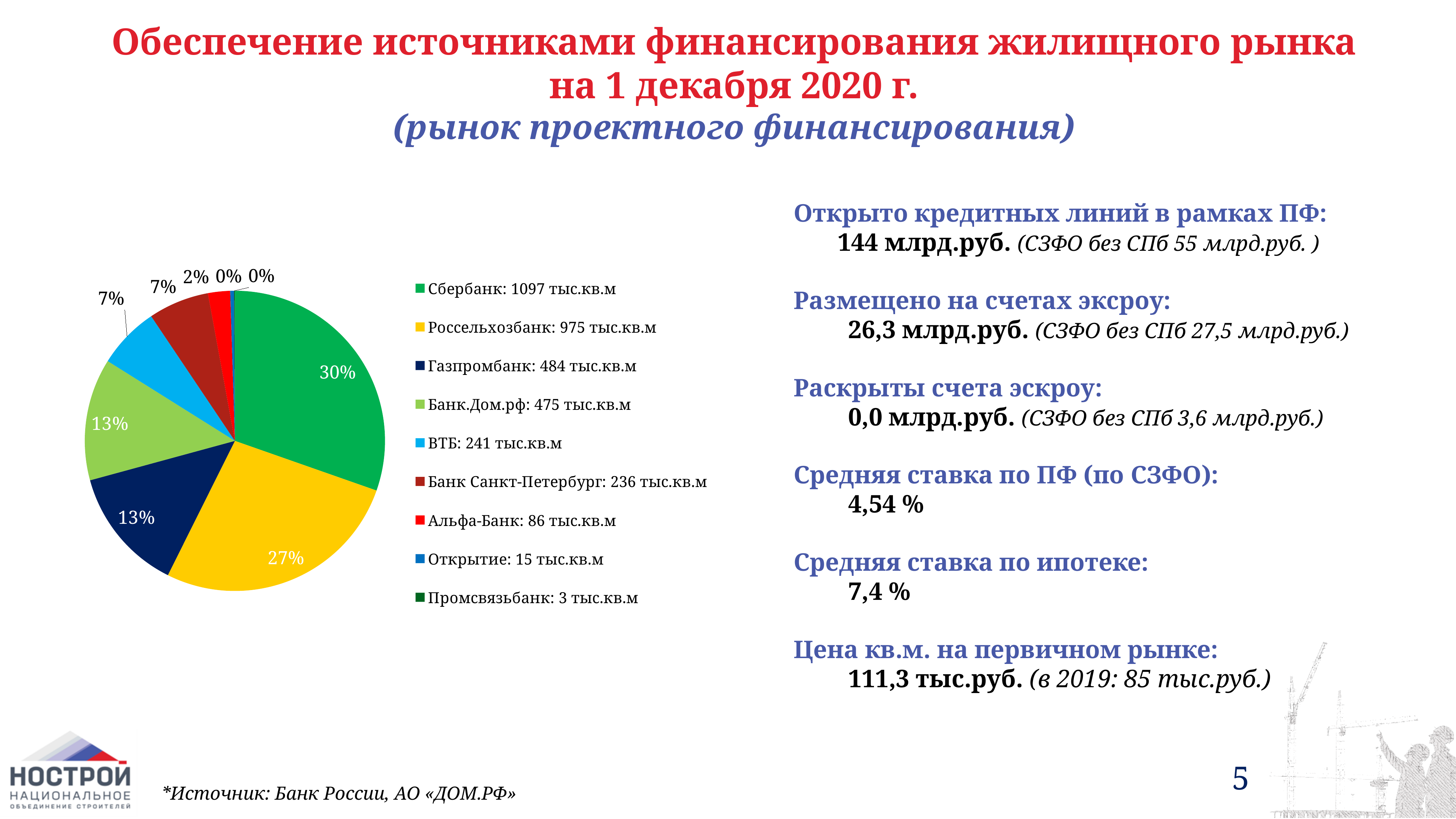
What share of the pie does Россельхозбанк hold? 27% Which bank has the smallest value in the legend? Промсвязьбанк Which bank has the largest share of the pie? Сбербанк What is the difference between the values for Сбербанк and Россельхозбанк? 122 тыс.кв.м What value does the legend give for Сбербанк? 1097 тыс.кв.м What value does the legend give for Открытие? 15 тыс.кв.м What type of chart is shown on the slide? pie chart What share of the pie does Альфа-Банк hold? 2% What value does the legend give for Газпромбанк? 484 тыс.кв.м Which is larger, the value for Газпромбанк or for Банк.Дом.рф? Газпромбанк What colour is the Сбербанк slice in the pie chart? green How many banks (slices) does the pie chart show? 9